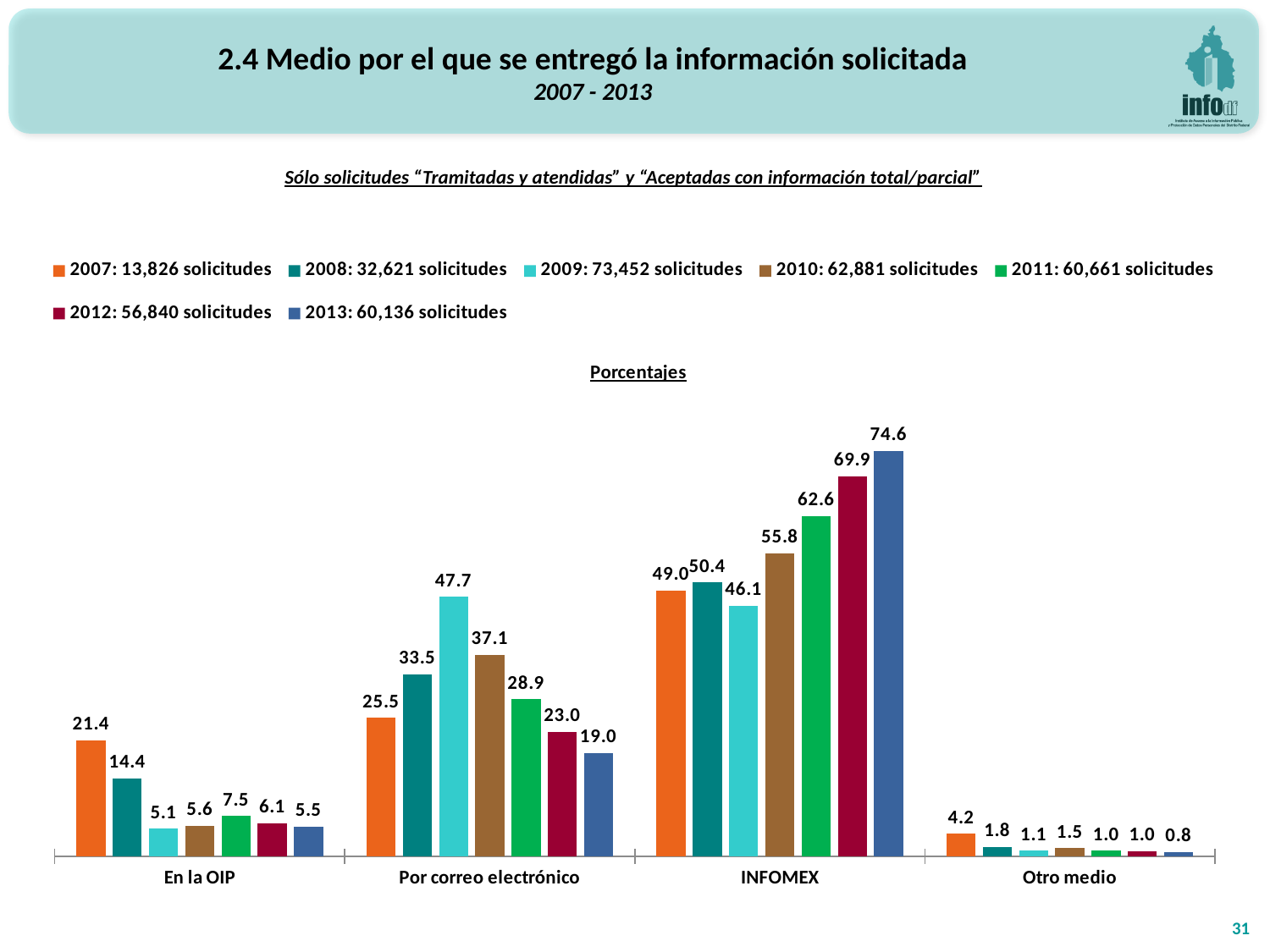
What is the value for 2009 in the Por correo electrónico category? 47.7 What is the value for 2013 in the INFOMEX category? 74.6 Which year has the highest value in the INFOMEX category? 2013 Which is larger in the Por correo electrónico category: the value for 2010 or the value for 2011? 2010 According to the legend, how many solicitudes were there in 2009? 73,452 What is the value for 2007 in the En la OIP category? 21.4 What type of chart is shown on the slide? Bar chart How many series does the legend list? 7 Do the values for INFOMEX rise or fall from 2010 to 2013? Rise How many categories are shown on the x axis? 4 What is the difference between the 2013 and 2007 values in the INFOMEX category? 25.6 Which year has the lowest value in the Otro medio category? 2013